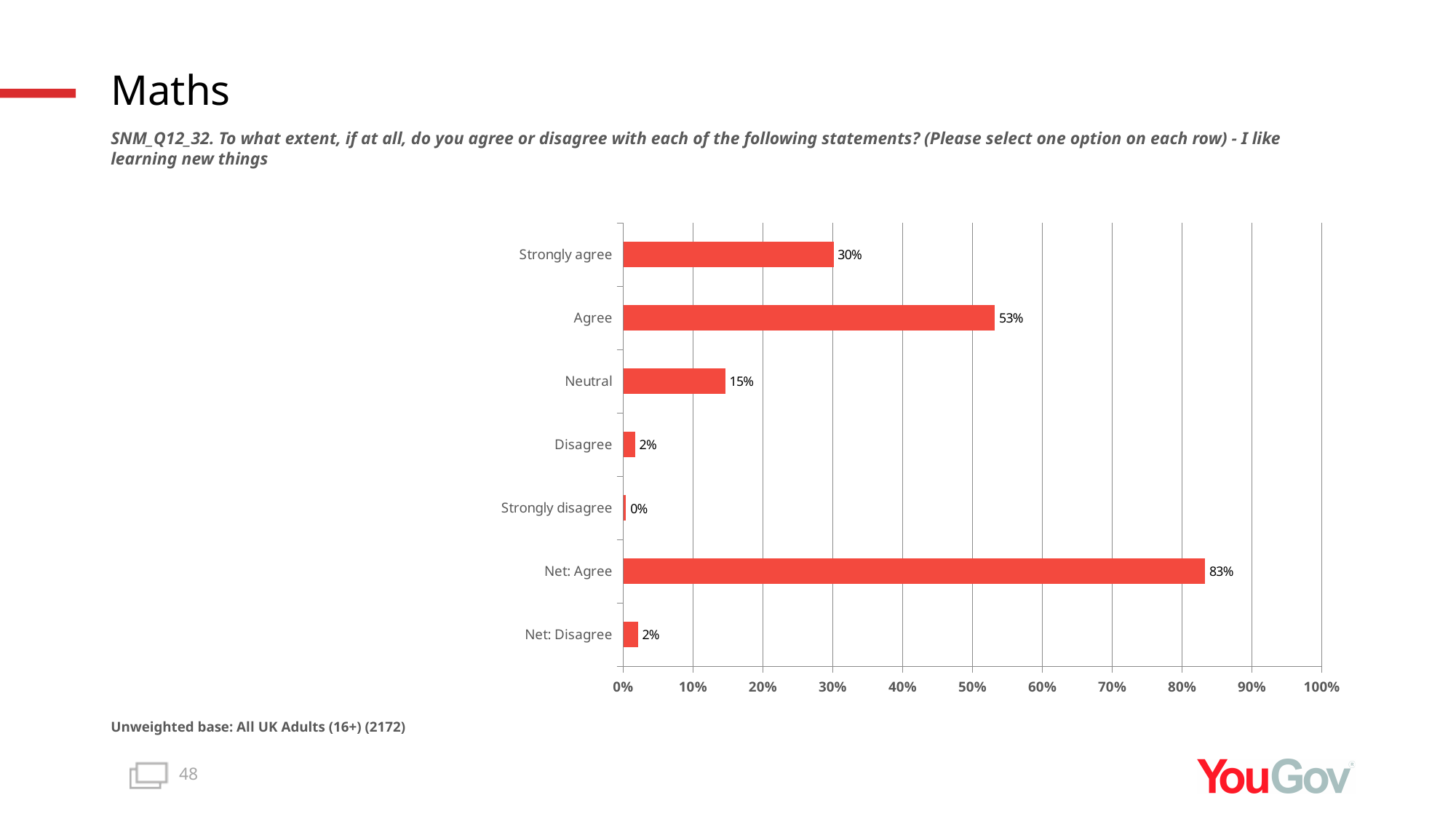
Which category has the lowest value? Strongly disagree What is the difference between 'Agree' and 'Strongly agree'? 23% What percentage of respondents selected 'Strongly agree'? 30% What is the unweighted base stated below the chart? All UK Adults (16+) (2172) Is the value for 'Net: Agree' greater or less than 80%? greater What is the value shown for 'Agree'? 53% Which category has the highest value? Net: Agree What percentage is shown for 'Neutral'? 15% Which is larger, 'Neutral' or 'Disagree'? Neutral What kind of chart is shown on the slide? Bar chart How many categories are shown on the chart? 7 What is the value for 'Net: Agree'? 83%